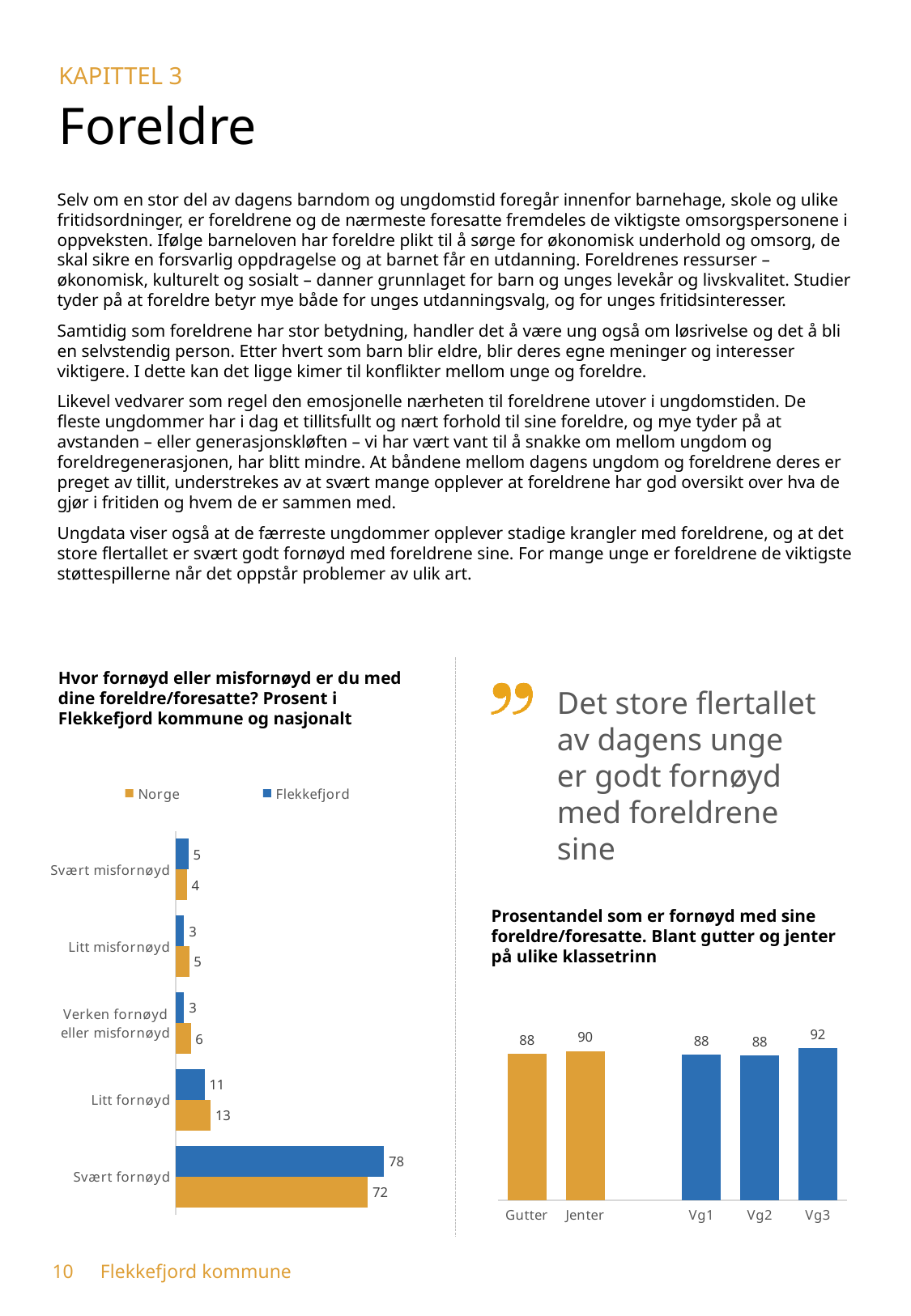
In the left chart (Hvor fornøyd eller misfornøyd er du med dine foreldre/foresatte?), what is the Norge value for Litt fornøyd? 13 In the left chart (Hvor fornøyd eller misfornøyd er du med dine foreldre/foresatte?), what is the Flekkefjord value for Svært fornøyd? 78 What kind of chart is the right chart (Prosentandel som er fornøyd med sine foreldre/foresatte)? Bar chart In the right chart (Prosentandel som er fornøyd med sine foreldre/foresatte), what is the difference between Vg3 and Vg1? 4 In the left chart (Hvor fornøyd eller misfornøyd er du med dine foreldre/foresatte?), how many categories are shown? 5 In the right chart (Prosentandel som er fornøyd med sine foreldre/foresatte), what is the value for Jenter? 90 In the left chart (Hvor fornøyd eller misfornøyd er du med dine foreldre/foresatte?), which colour represents Flekkefjord? Blue In the left chart (Hvor fornøyd eller misfornøyd er du med dine foreldre/foresatte?), what is the difference between the Flekkefjord and Norge values for Svært fornøyd? 6 In the left chart (Hvor fornøyd eller misfornøyd er du med dine foreldre/foresatte?), which category has the highest Flekkefjord value? Svært fornøyd In the right chart (Prosentandel som er fornøyd med sine foreldre/foresatte), which category has the highest value? Vg3 In the left chart (Hvor fornøyd eller misfornøyd er du med dine foreldre/foresatte?), which is larger for Verken fornøyd eller misfornøyd: Norge or Flekkefjord? Norge In the left chart (Hvor fornøyd eller misfornøyd er du med dine foreldre/foresatte?), how many series does the legend list? 2